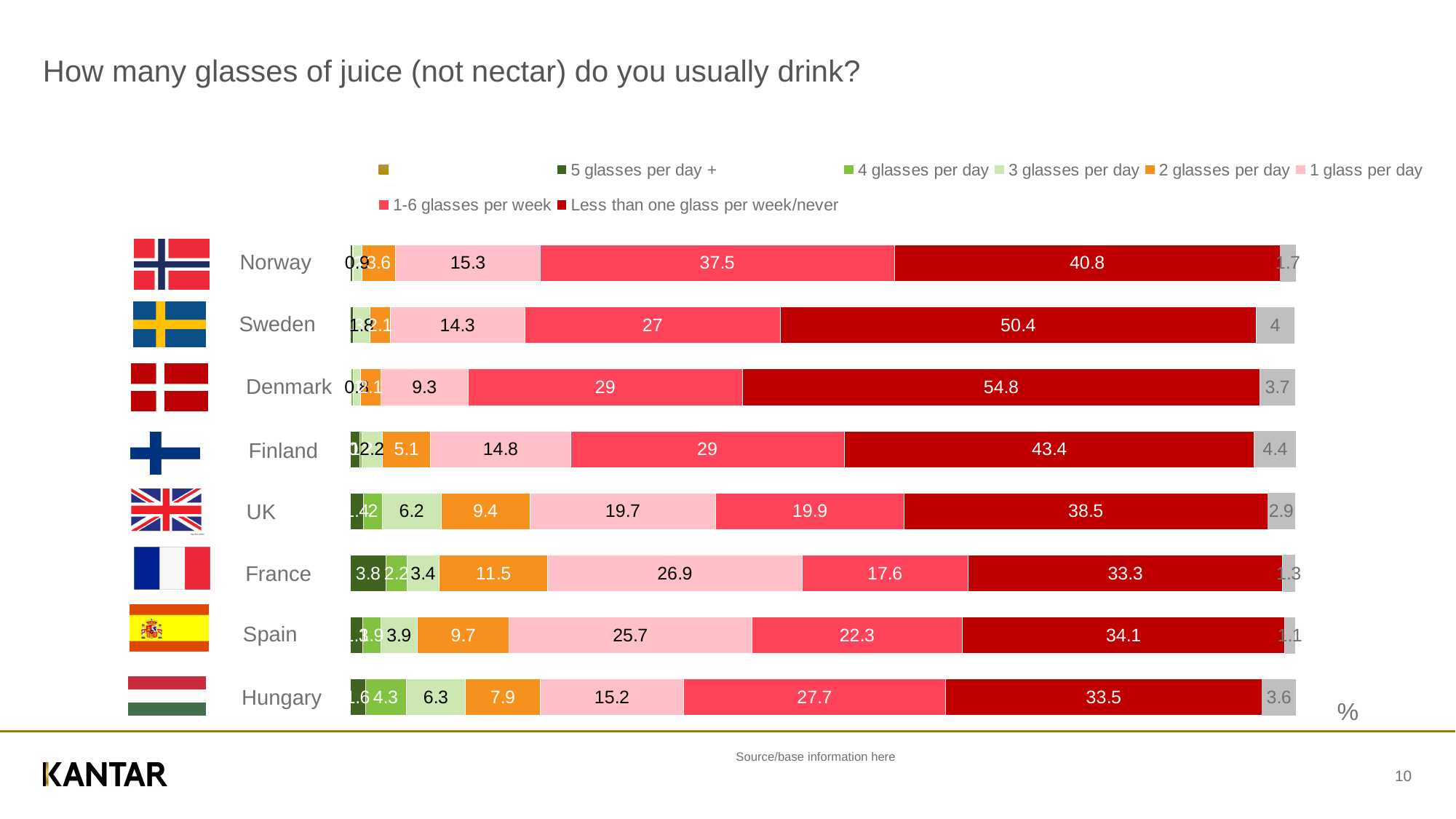
Which country has the highest value for '1 glass per day'? France What is the value for 'Less than one glass per week/never' for Denmark? 54.8 What is the value for '1 glass per day' for the UK? 19.7 What is the title of the chart on the slide? How many glasses of juice (not nectar) do you usually drink? What kind of chart is shown on the slide? Stacked bar chart Which country has the highest value for '1-6 glasses per week'? Norway Which country has the highest value for 'Less than one glass per week/never'? Denmark What is the value for '2 glasses per day' for Hungary? 7.9 What is the value for '1-6 glasses per week' for Finland? 29 How many countries are shown in the chart? 8 What is the difference between Sweden's and Norway's values for 'Less than one glass per week/never'? 9.6 Which has the larger value for '1 glass per day', France or Spain? France